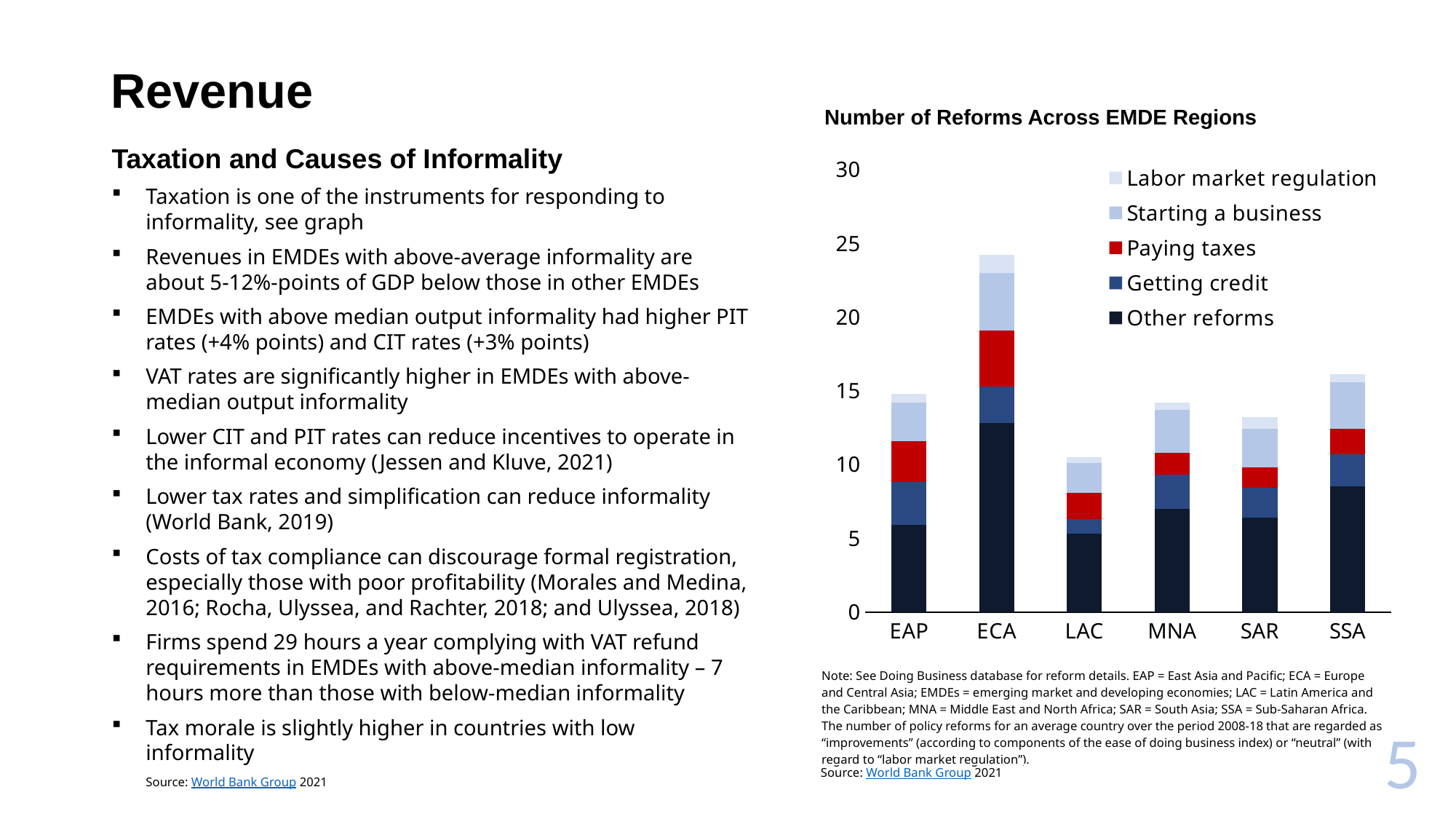
How many regions are shown on the x axis of the chart? 6 How many series does the chart's legend list? 5 Which region has the highest total number of reforms? ECA Which region has a larger total number of reforms, SSA or SAR? SSA What is the title of the chart? Number of Reforms Across EMDE Regions Is the total number of reforms for ECA greater or less than 20? greater Which series is shown in red in the chart? Paying taxes Which region has the lowest total number of reforms? LAC Is the 'Other reforms' segment for ECA greater or less than 10? greater What kind of chart is shown on the slide? Stacked bar chart Is the total number of reforms for EAP greater or less than 20? less